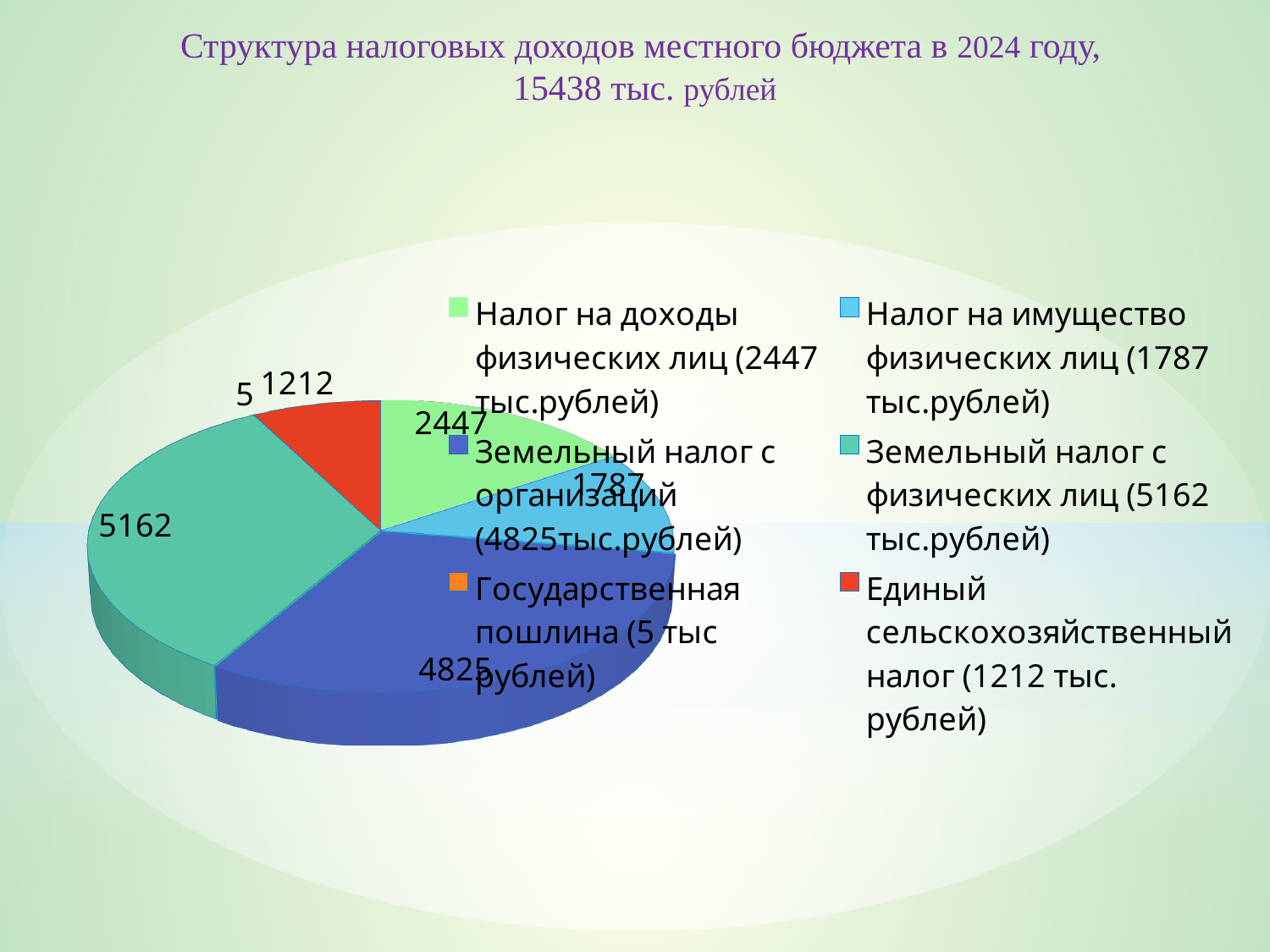
What total amount is stated in the chart title? 15438 тыс. рублей What is the value for Земельный налог с физических лиц? 5162 Which category has the smallest slice of the pie? Государственная пошлина What is the difference between Земельный налог с физических лиц and Земельный налог с организаций? 337 What is the difference between Налог на доходы физических лиц and Налог на имущество физических лиц? 660 What is the value for Государственная пошлина? 5 Which category has the largest slice of the pie? Земельный налог с физических лиц Which is larger: Налог на доходы физических лиц or Единый сельскохозяйственный налог? Налог на доходы физических лиц How many entries does the legend list? 6 What kind of chart is shown on the slide? Pie chart How many slices does the pie chart have? 6 What is the value for Налог на имущество физических лиц? 1787